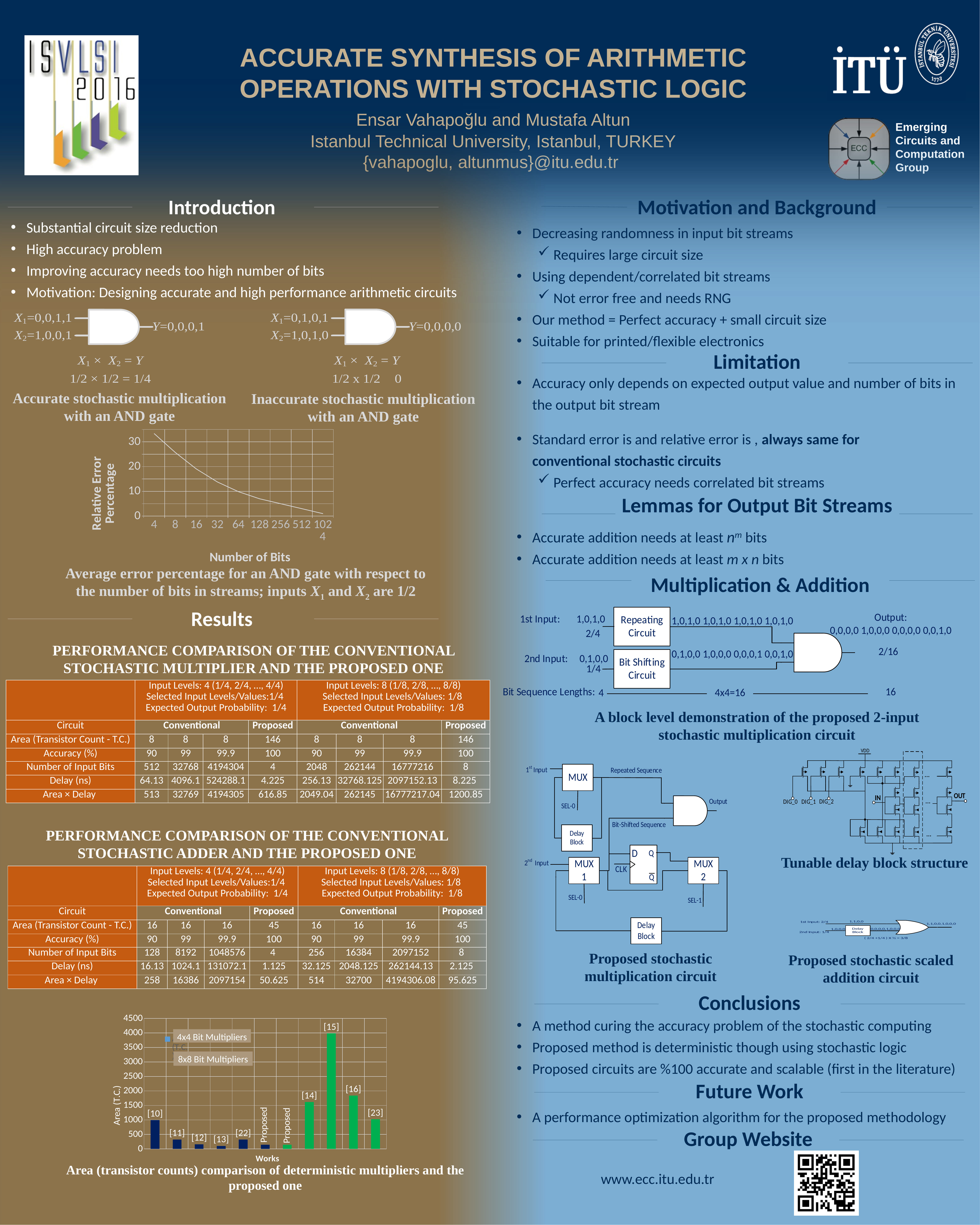
In the area (transistor counts) comparison bar chart, is the area for [15] greater or less than 3500? greater In the area (transistor counts) comparison bar chart, how many bars are plotted? 11 In the relative error percentage line chart, is the value at 1024 bits greater or less than 10? less In the relative error percentage line chart, is the value at 8 bits greater or less than 20? greater In the relative error percentage line chart, does the relative error rise or fall as the number of bits increases? fall What kind of chart is the chart titled 'Average error percentage for an AND gate' on the left side of the slide? line chart What kind of chart is the area (transistor counts) comparison chart at the bottom left of the slide? bar chart In the relative error percentage line chart, how many number-of-bits values are marked on the x axis? 9 In the area (transistor counts) comparison bar chart, how many series does the legend list? 2 In the relative error percentage line chart, what is the label of the y axis? Relative Error Percentage In the area (transistor counts) comparison bar chart, which work has the highest area? [15] In the area (transistor counts) comparison bar chart, which has the larger area, [14] or [11]? [14]